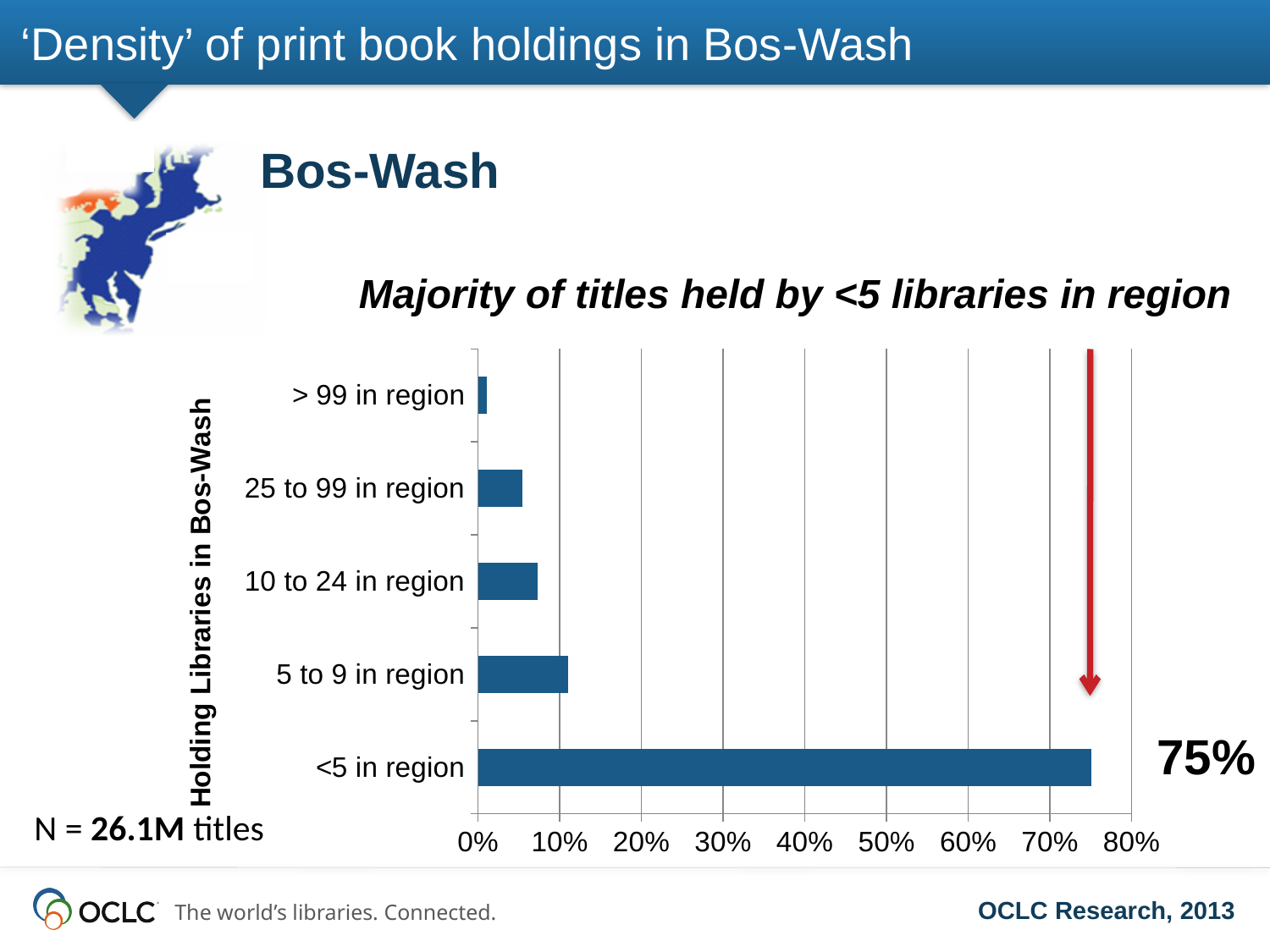
How many categories are shown on the chart? 5 Which category has the lowest value? > 99 in region Which category has the highest value? <5 in region What is the title of the chart's vertical axis? Holding Libraries in Bos-Wash What kind of chart is shown on the slide? Bar chart What is the total number of titles (N) stated on the slide? 26.1M titles Which is larger, the value for "5 to 9 in region" or "10 to 24 in region"? 5 to 9 in region What is the value for the "<5 in region" category? 75% Is the value for "<5 in region" greater or less than 70%? greater Is the value for "10 to 24 in region" greater or less than 10%? less Is the value for "5 to 9 in region" greater or less than 20%? less Which is larger, the value for "<5 in region" or "25 to 99 in region"? <5 in region